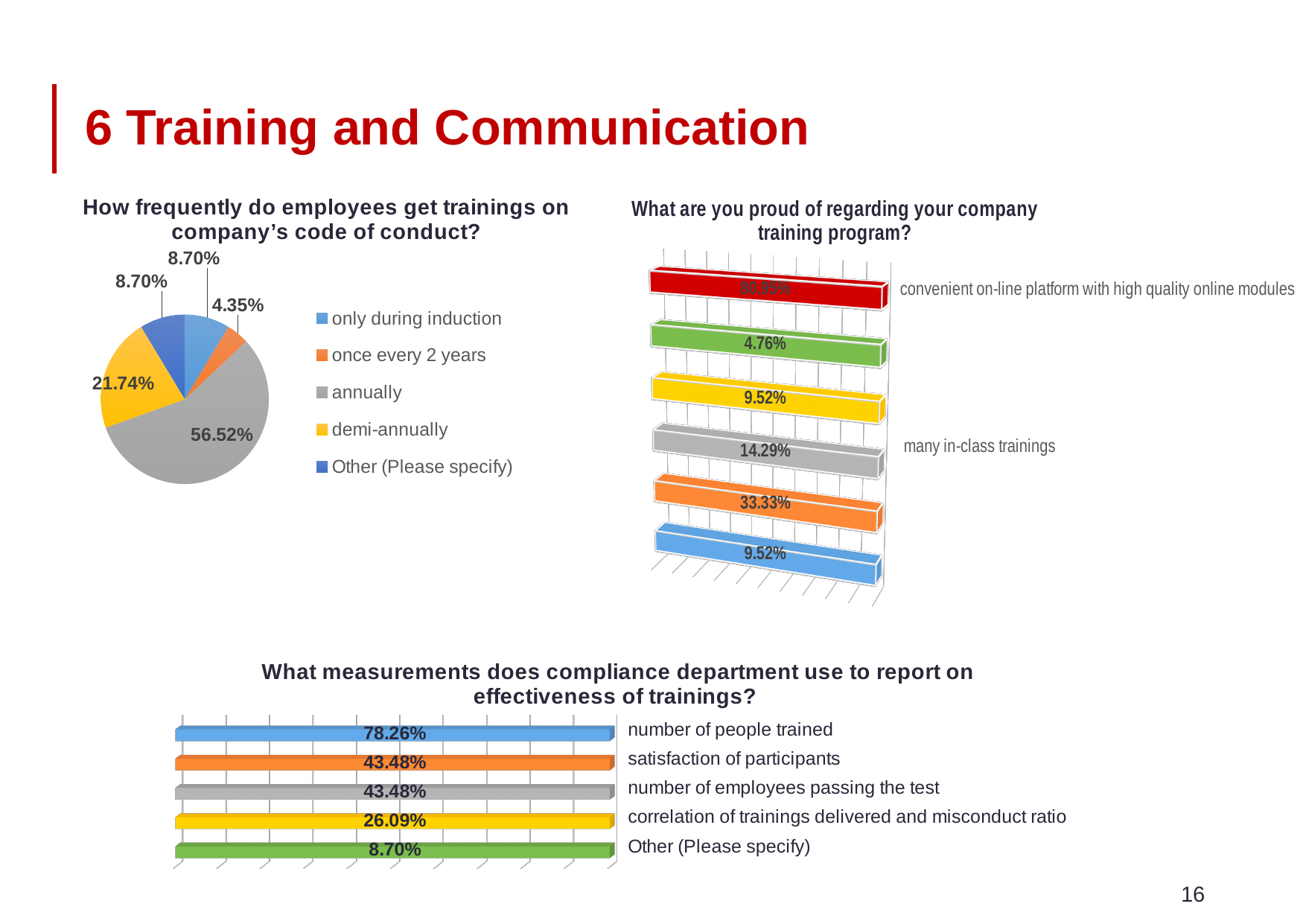
How many categories does the legend of the pie chart 'How frequently do employees get trainings on company's code of conduct?' list? 5 In the pie chart 'How frequently do employees get trainings on company's code of conduct?', what share is 'demi-annually'? 21.74% In the chart 'What are you proud of regarding your company training program?', what is the value for 'many in-class trainings'? 14.29% How many bars are plotted in the chart 'What are you proud of regarding your company training program?'? 6 In the pie chart 'How frequently do employees get trainings on company's code of conduct?', which category has the largest share? annually In the chart 'What measurements does compliance department use to report on effectiveness of trainings?', what is the value for 'number of people trained'? 78.26% In the pie chart 'How frequently do employees get trainings on company's code of conduct?', what share is 'once every 2 years'? 4.35% In the pie chart 'How frequently do employees get trainings on company's code of conduct?', which category has the smallest share? once every 2 years In the chart 'What measurements does compliance department use to report on effectiveness of trainings?', what is the value for 'correlation of trainings delivered and misconduct ratio'? 26.09% What kind of chart is 'What measurements does compliance department use to report on effectiveness of trainings?'? bar chart In the chart 'What measurements does compliance department use to report on effectiveness of trainings?', what is the difference between 'number of people trained' and 'satisfaction of participants'? 34.78% In the pie chart 'How frequently do employees get trainings on company's code of conduct?', what share is 'annually'? 56.52%